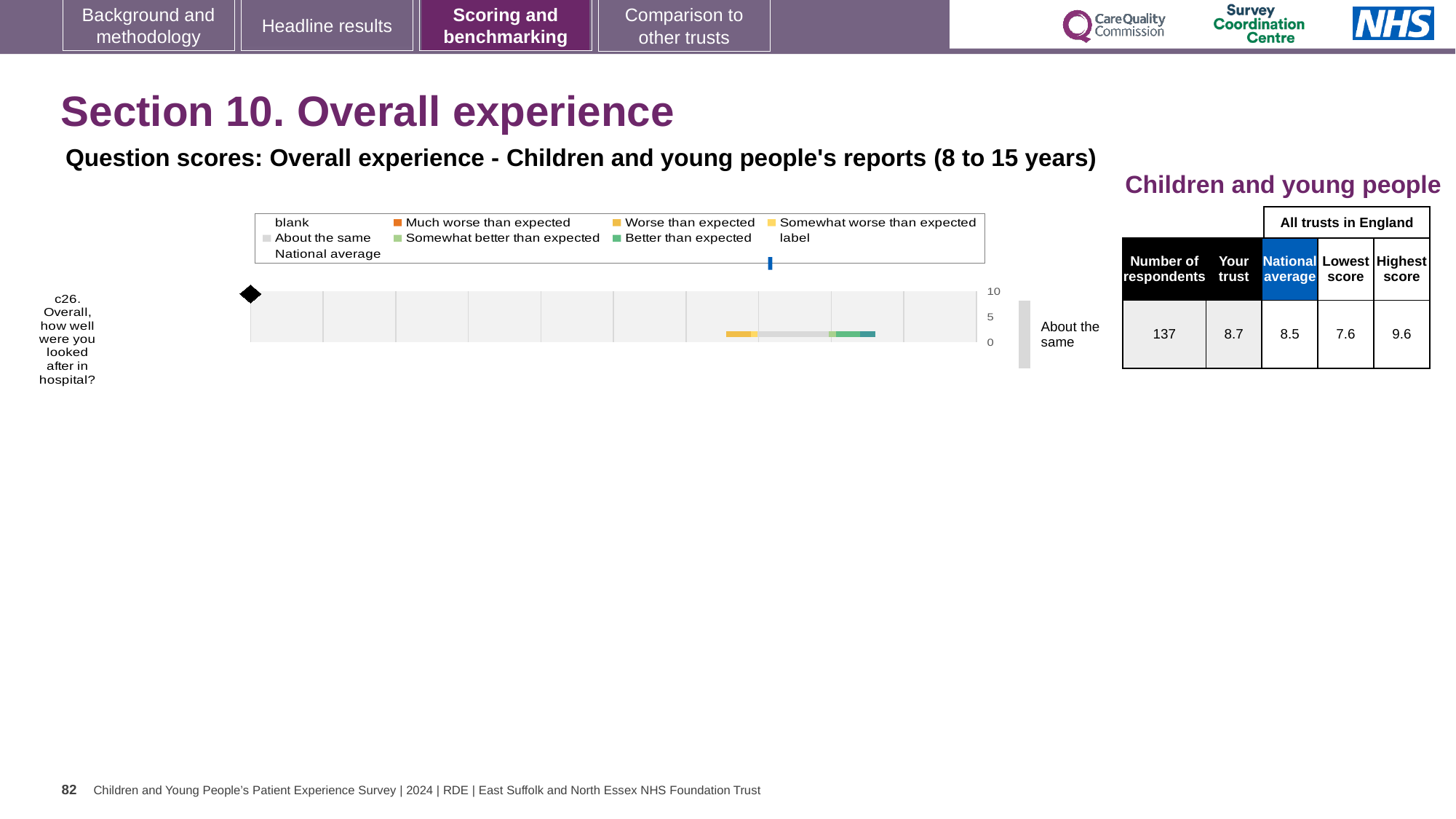
What is the 'Your trust' score for question c26 'Overall, how well were you looked after in hospital?' 8.7 How many respondents answered question c26? 137 How many questions are plotted in the chart? 1 What is the highest score among all trusts in England for question c26? 9.6 What is the title of the chart? Question scores: Overall experience - Children and young people's reports (8 to 15 years) What is the difference between the trust's score and the national average for question c26? 0.2 Is the trust's score for question c26 higher or lower than the national average? higher What is the lowest score among all trusts in England for question c26? 7.6 What is the difference between the highest and lowest trust scores for question c26? 2.0 How is the trust's result for question c26 categorised relative to other trusts? About the same What is the national average score for question c26? 8.5 What kind of chart is shown on the slide? bar chart